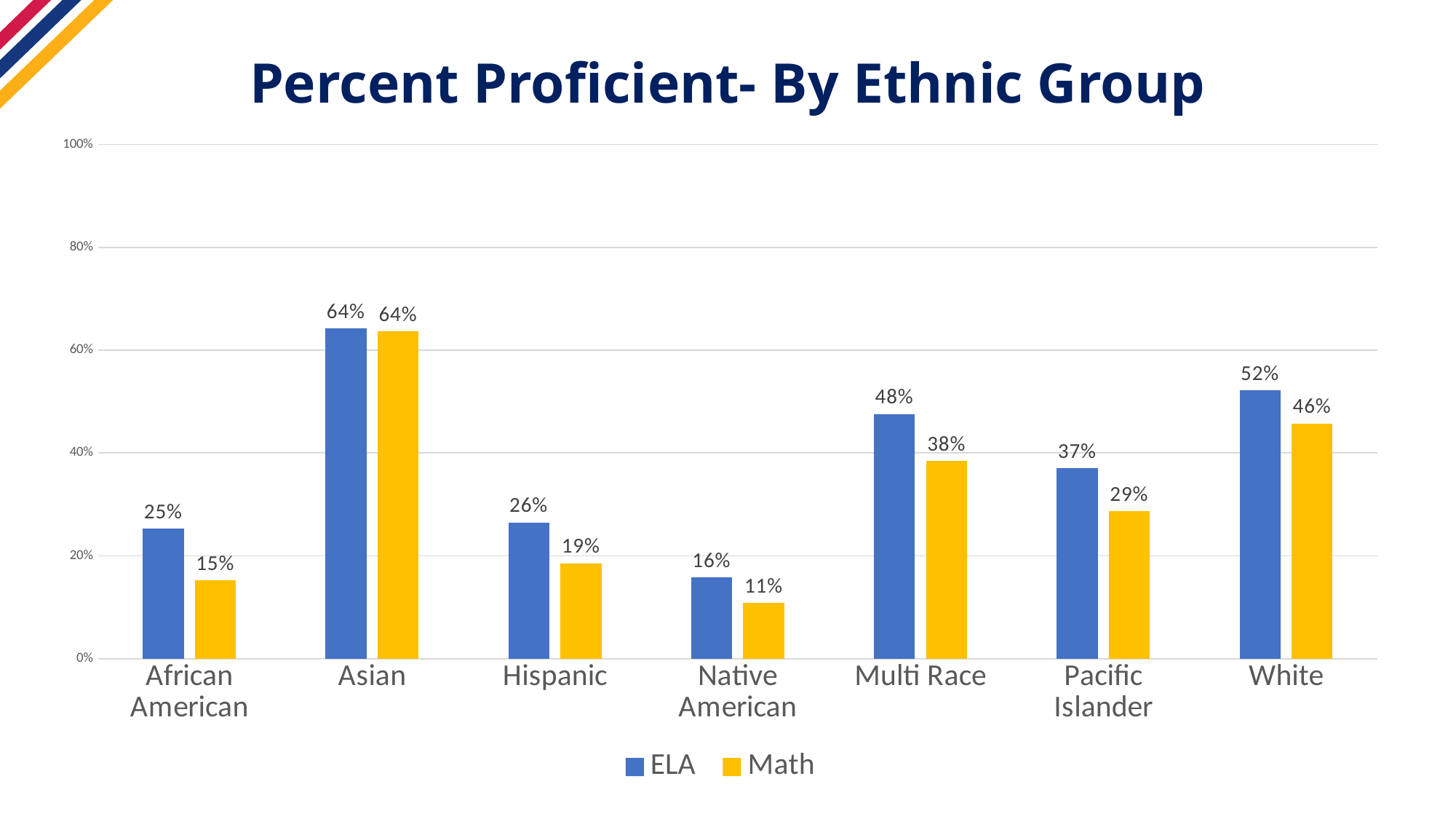
Which ethnic group has the lowest Math percent proficient? Native American What is the difference between the ELA and Math percent proficient for Multi Race students? 10% How many ethnic groups are shown on the x axis? 7 What kind of chart is shown on the slide? Bar chart What is the ELA percent proficient for African American students? 25% How many series does the legend list? 2 Is the Math percent proficient for Asian students greater or less than 60%? greater What is the Math percent proficient for Pacific Islander students? 29% What is the title of the chart? Percent Proficient- By Ethnic Group What is the Math percent proficient for White students? 46% Which is larger, the ELA percent proficient for Hispanic students or for Pacific Islander students? Pacific Islander Which ethnic group has the highest ELA percent proficient? Asian